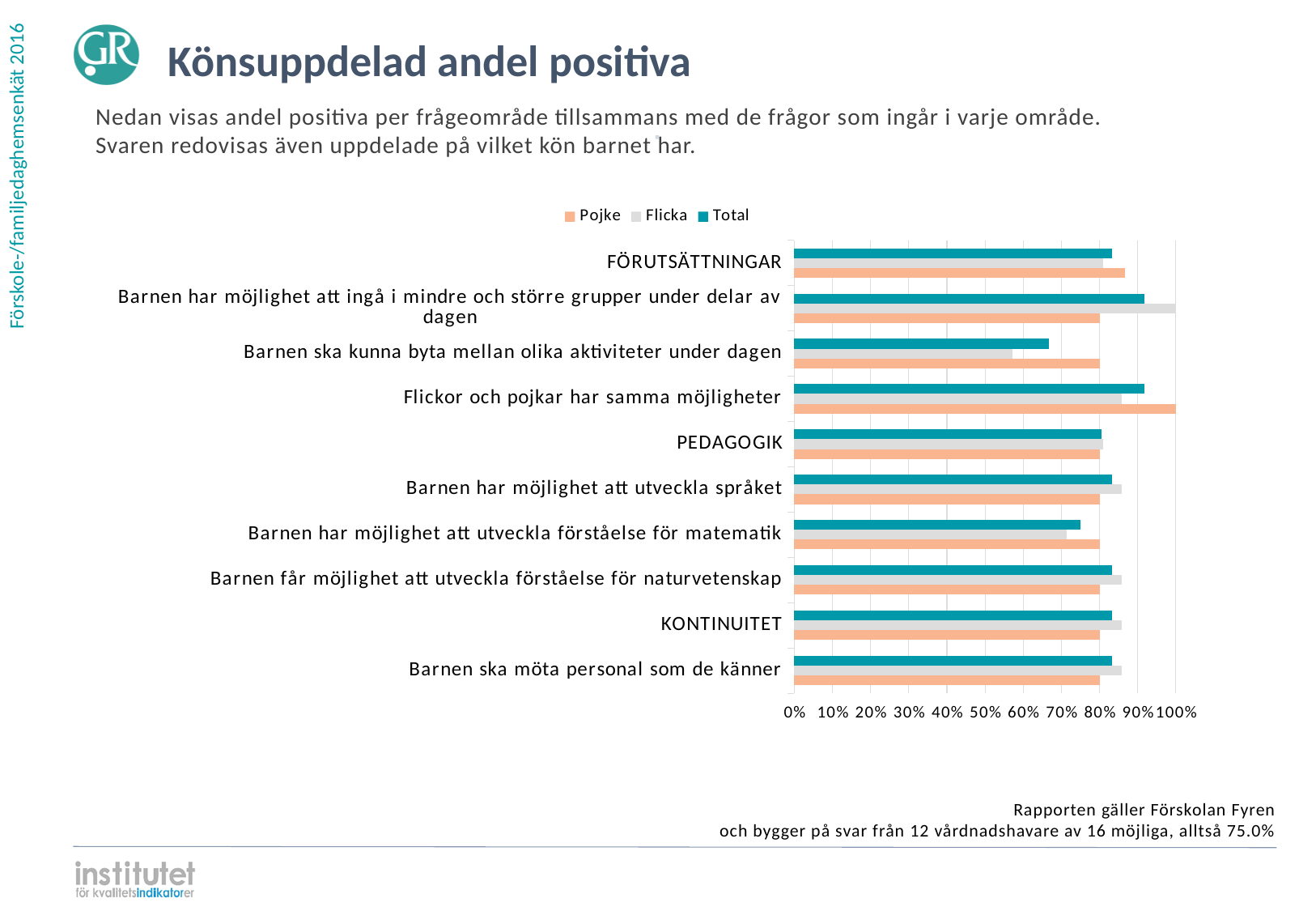
What kind of chart is shown on the slide? Bar chart How many categories are plotted on the y axis of the chart? 10 For 'Barnen har möjlighet att ingå i mindre och större grupper under delar av dagen', which is larger: the Flicka value or the Pojke value? Flicka What are the three series named in the legend? Pojke, Flicka, Total Is the Total value for 'Barnen har möjlighet att utveckla förståelse för matematik' greater or less than 80%? less Which category has the lowest Total value? Barnen ska kunna byta mellan olika aktiviteter under dagen Is the Total value for 'Barnen ska kunna byta mellan olika aktiviteter under dagen' greater or less than 80%? less Is the Flicka value for 'Barnen ska kunna byta mellan olika aktiviteter under dagen' greater or less than 70%? less Which category has the highest Pojke value? Flickor och pojkar har samma möjligheter For 'Barnen ska kunna byta mellan olika aktiviteter under dagen', which is larger: the Pojke value or the Flicka value? Pojke How many series does the legend list? 3